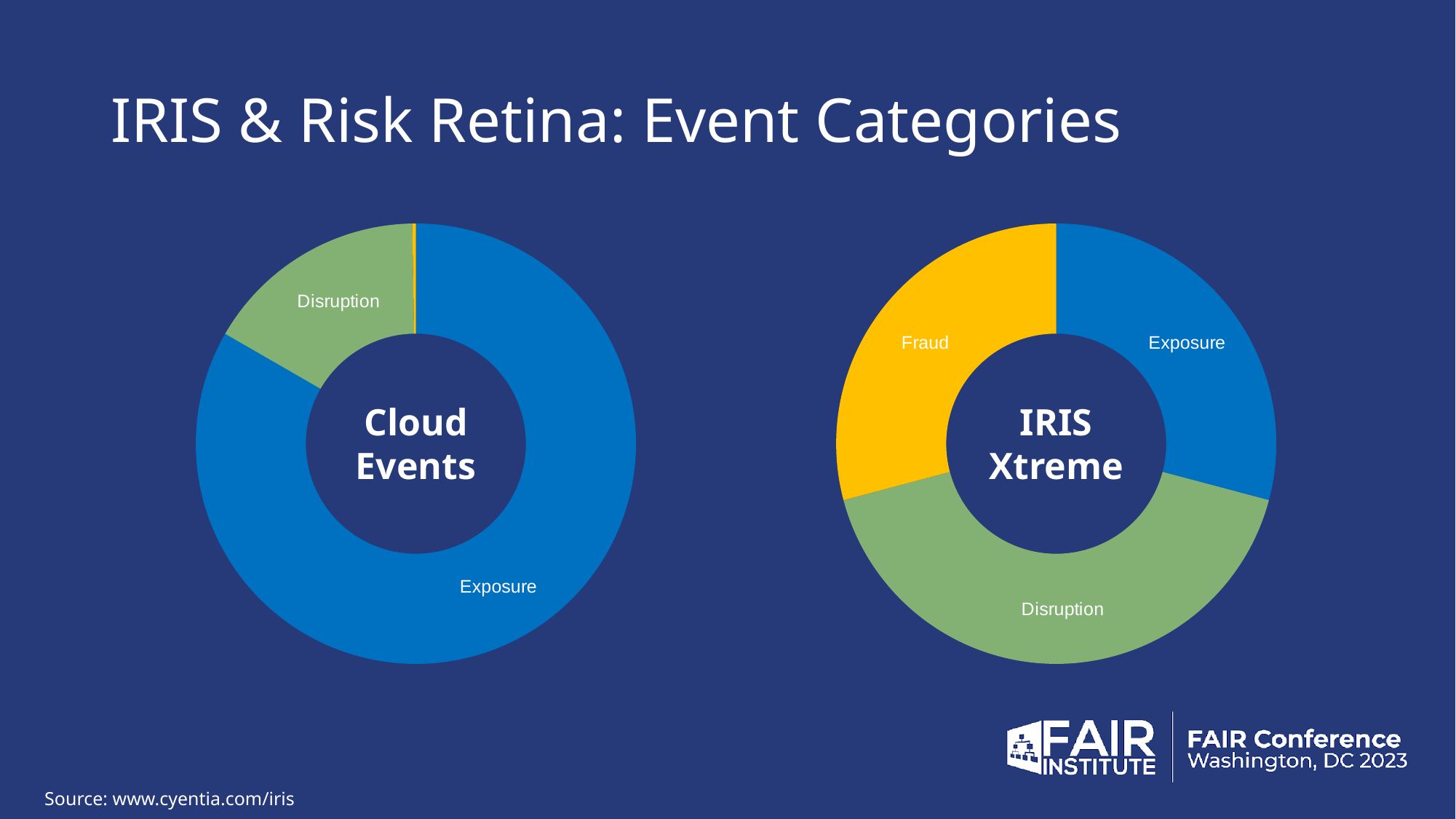
In the IRIS Xtreme chart, which category has the largest share? Disruption What colour is the Fraud segment in the IRIS Xtreme chart? Yellow What kind of chart is the Cloud Events chart? Donut (pie) chart What kind of chart is the IRIS Xtreme chart? Donut (pie) chart In the Cloud Events chart, which is larger, Exposure or Disruption? Exposure In the IRIS Xtreme chart, which is larger, Disruption or Fraud? Disruption Which category appears in the IRIS Xtreme chart but is not labeled in the Cloud Events chart? Fraud How many labeled categories does the IRIS Xtreme chart show? 3 In the Cloud Events chart, which category has the largest share? Exposure In the IRIS Xtreme chart, which is larger, Disruption or Exposure? Disruption